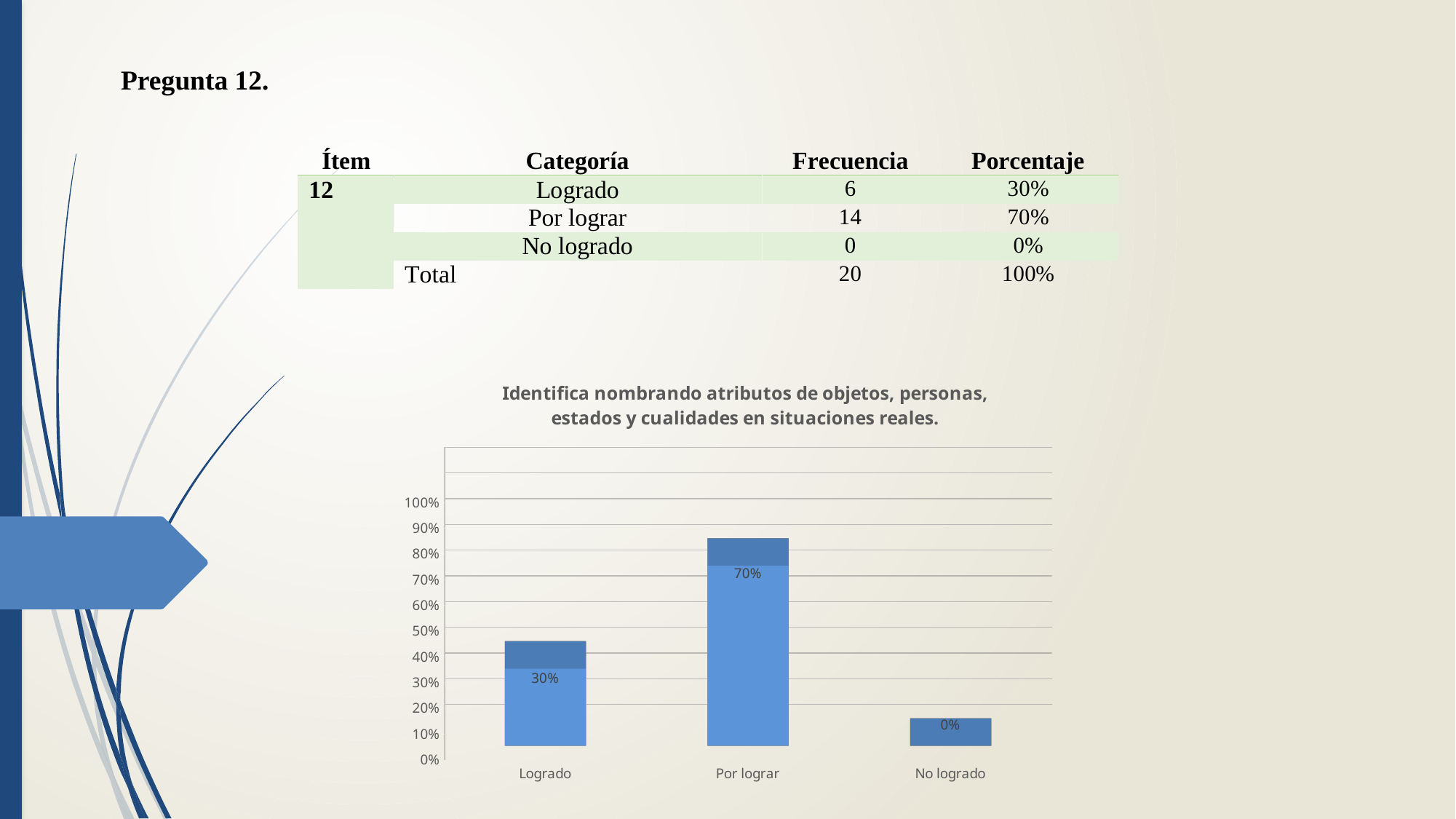
What kind of chart is shown on the slide? bar chart What is the value shown for No logrado? 0% Is the value for Por lograr greater or less than 50%? greater What is the highest value labelled on the y axis of the chart? 100% Which is larger, the value for Logrado or the value for Por lograr? Por lograr Which category has the highest value? Por lograr How many categories are shown on the x axis? 3 What is the value shown for Logrado? 30% What is the title of the chart? Identifica nombrando atributos de objetos, personas, estados y cualidades en situaciones reales. What is the difference between the values for Por lograr and Logrado? 40% What is the value shown for Por lograr? 70% Which category has the lowest value? No logrado